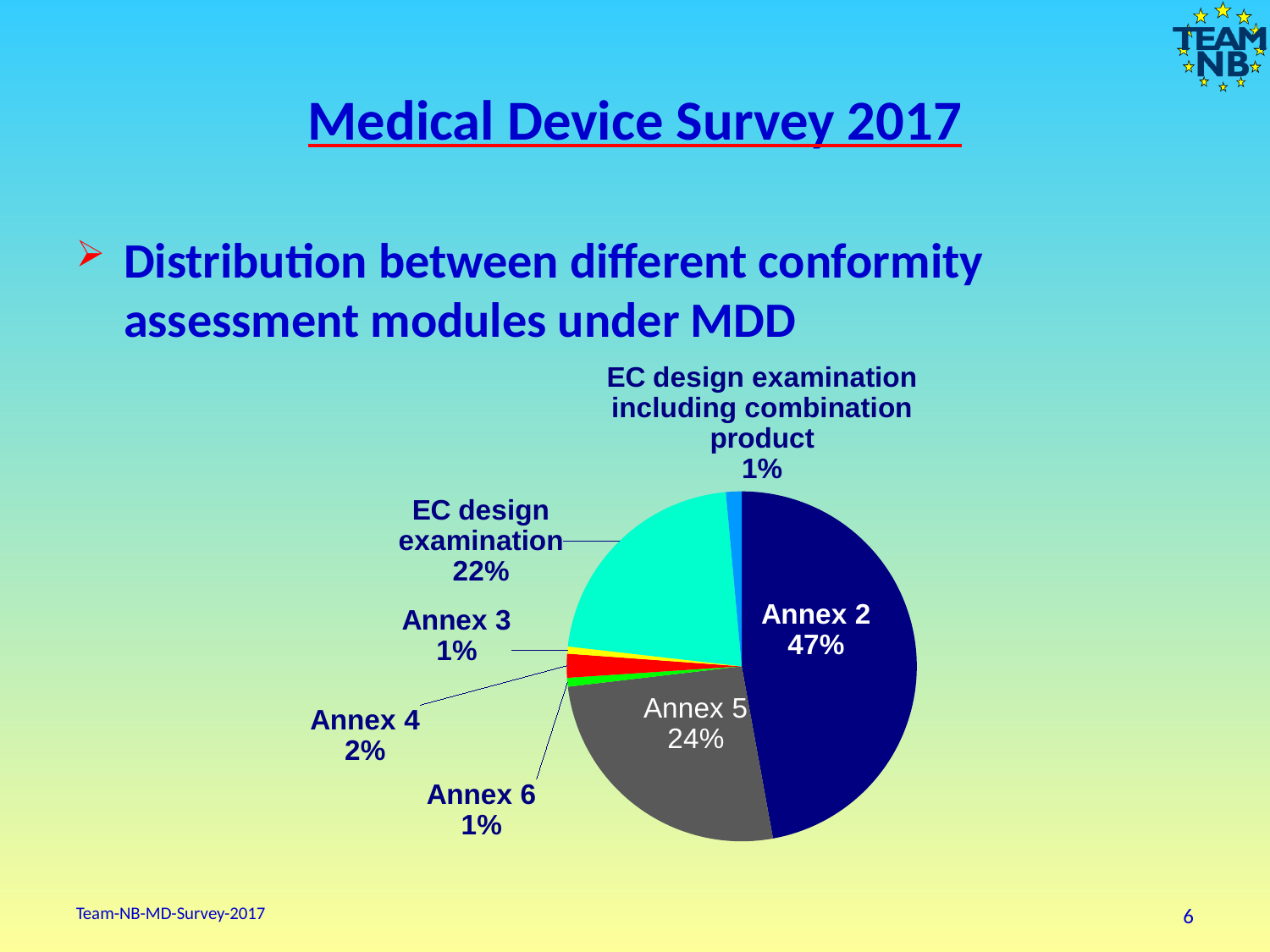
Which category has the largest slice of the pie? Annex 2 What share of the pie does Annex 2 represent? 47% How many slices does the pie chart have? 7 What is the difference in percentage points between EC design examination and Annex 4? 20 What percentage is shown for Annex 4? 2% What percentage is shown for EC design examination? 22% What colour is the Annex 2 slice? dark blue What percentage is shown for EC design examination including combination product? 1% Which is larger, the share for Annex 5 or the share for EC design examination? Annex 5 What is the difference in percentage points between Annex 2 and Annex 5? 23 What kind of chart is shown on the slide? pie chart What percentage is shown for Annex 5? 24%